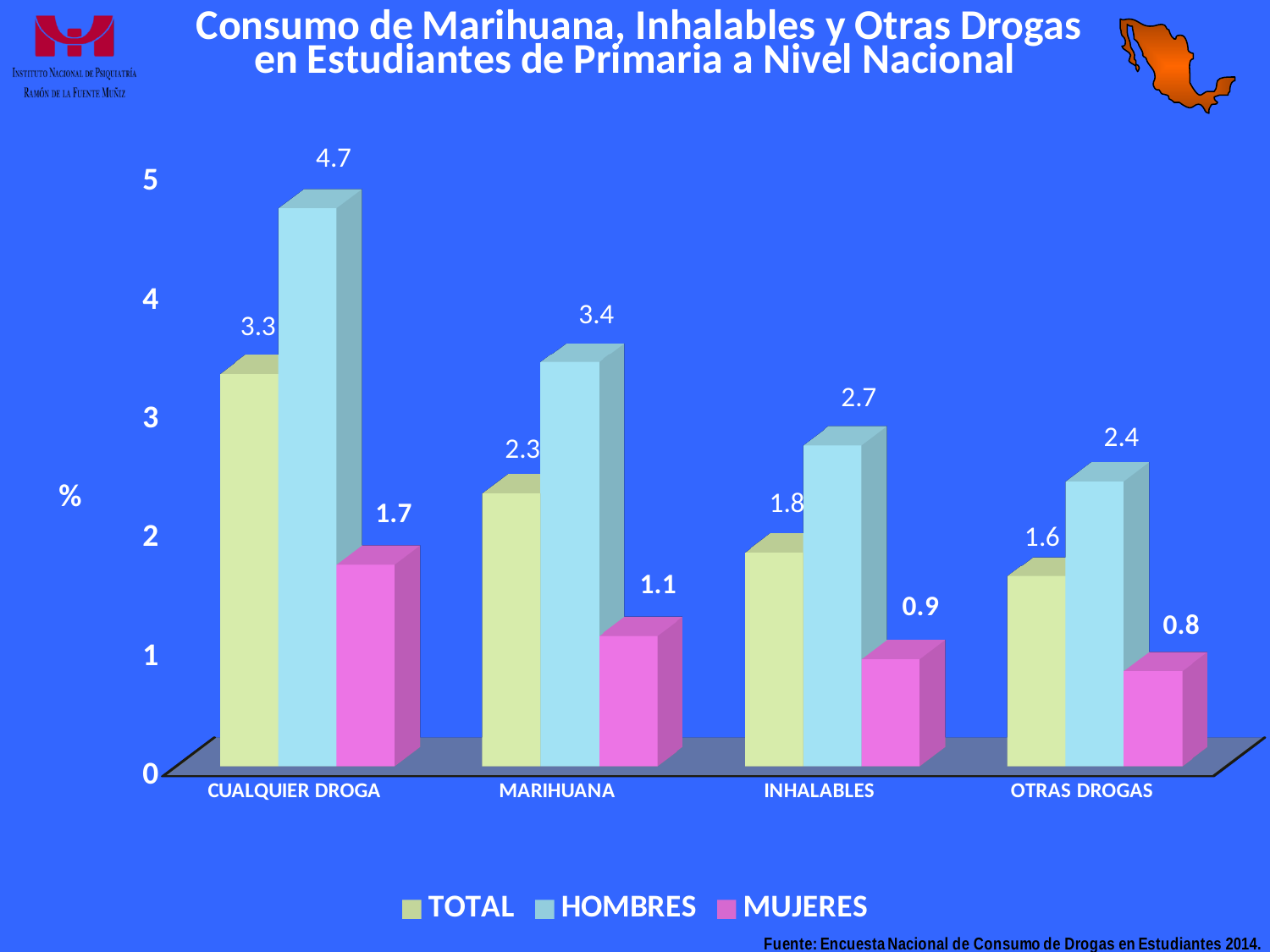
What is the TOTAL value for INHALABLES? 1.8 What kind of chart is shown on the slide? Bar chart What unit is shown on the y axis label? % What is the value for MUJERES in the MARIHUANA category? 1.1 What is the value for HOMBRES in the CUALQUIER DROGA category? 4.7 How many categories are shown on the x axis? 4 What is the difference between the HOMBRES and MUJERES values for CUALQUIER DROGA? 3.0 Which is larger, the TOTAL value for MARIHUANA or the HOMBRES value for OTRAS DROGAS? HOMBRES value for OTRAS DROGAS Do the TOTAL values rise or fall from CUALQUIER DROGA to OTRAS DROGAS? Fall Which category has the highest HOMBRES value? CUALQUIER DROGA Which category has the lowest MUJERES value? OTRAS DROGAS How many series does the legend list? 3